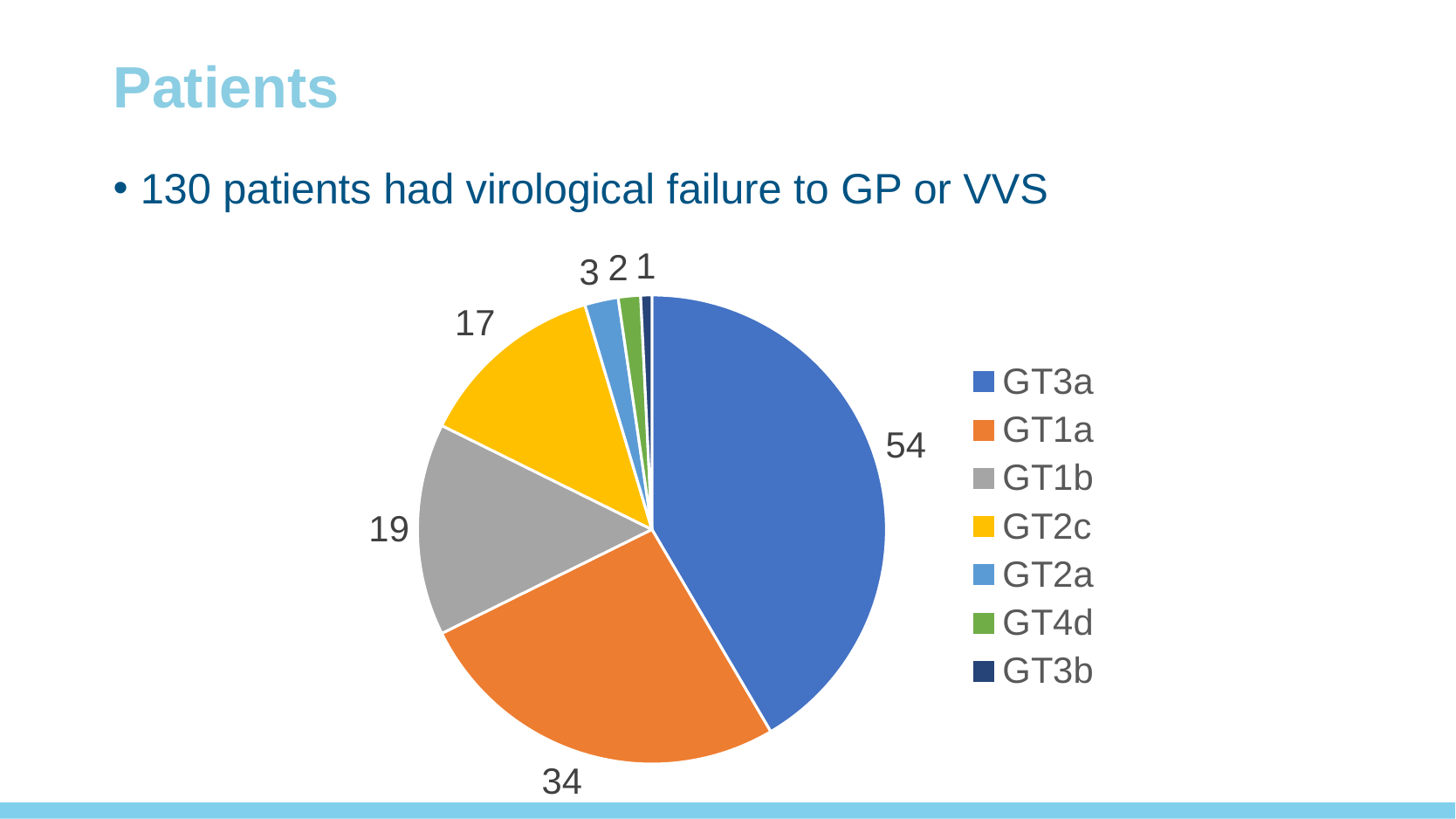
What value is shown for GT2c in the pie chart? 17 How many genotype categories does the pie chart legend list? 7 How many patients are in the GT3a slice of the pie chart? 54 Which is larger in the pie chart, GT1b or GT2c? GT1b What value is shown for GT1b in the pie chart? 19 What kind of chart is shown on the slide? pie chart What is the total of all the slice values in the pie chart? 130 What colour is the GT2c slice in the pie chart? yellow Which genotype has the smallest slice of the pie chart? GT3b What is the difference between the GT3a and GT1a values in the pie chart? 20 What value is shown for GT1a in the pie chart? 34 Which genotype has the largest slice of the pie chart? GT3a